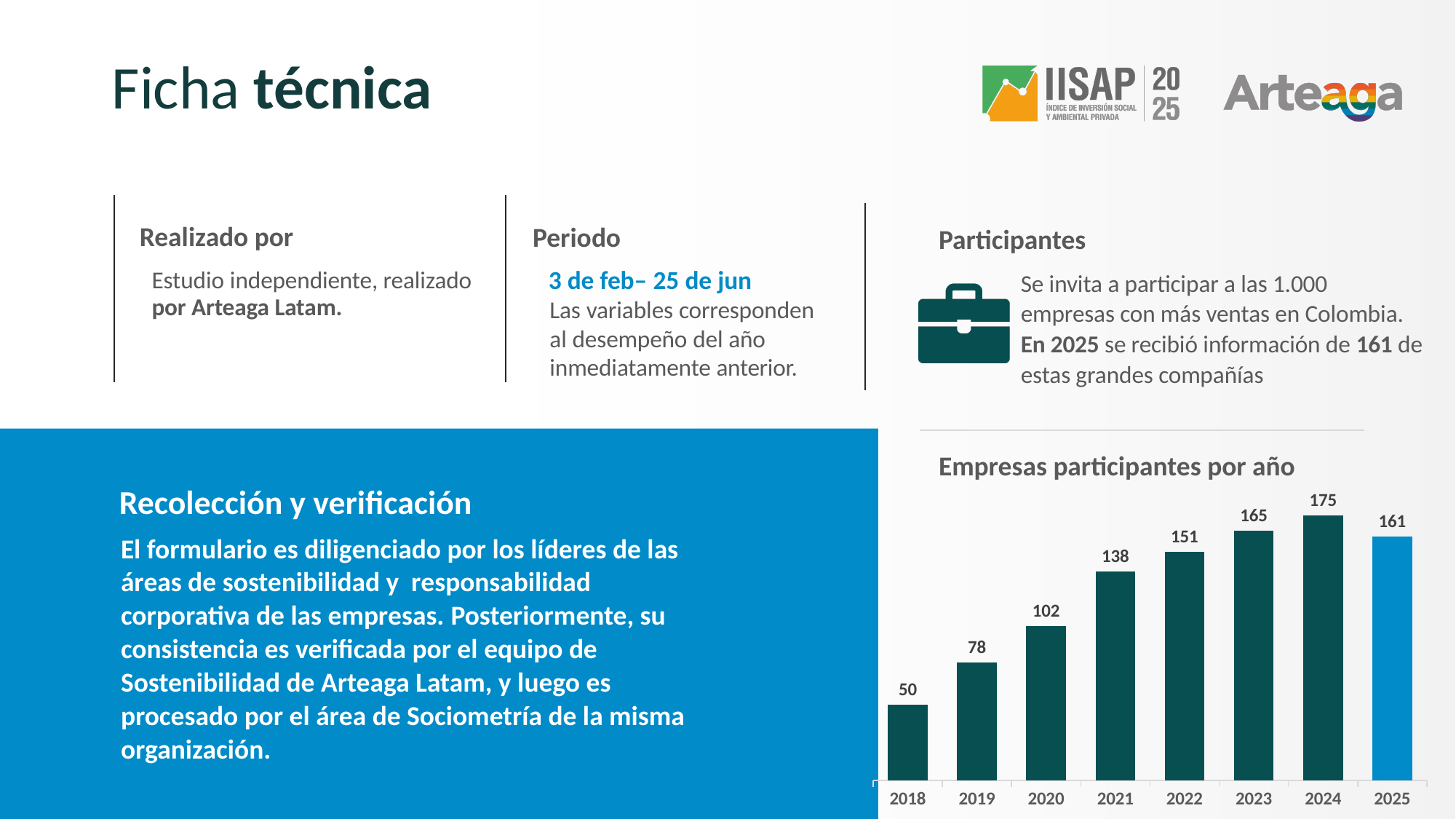
Which year has the highest value in the chart? 2024 What is the title of the chart on the slide? Empresas participantes por año How many years are shown on the x axis of the chart? 8 Do the values rise or fall from 2018 to 2024 in the chart? rise Which is larger, the value for 2023 or the value for 2025? 2023 How many participating companies does the chart show for 2022? 151 Which year has the lowest value in the chart? 2018 What is the value for 2018 in the 'Empresas participantes por año' chart? 50 What kind of chart is 'Empresas participantes por año'? bar chart What is the difference between the values for 2024 and 2025? 14 What is the difference between the values for 2021 and 2020? 36 What is the value for 2025 in the chart? 161